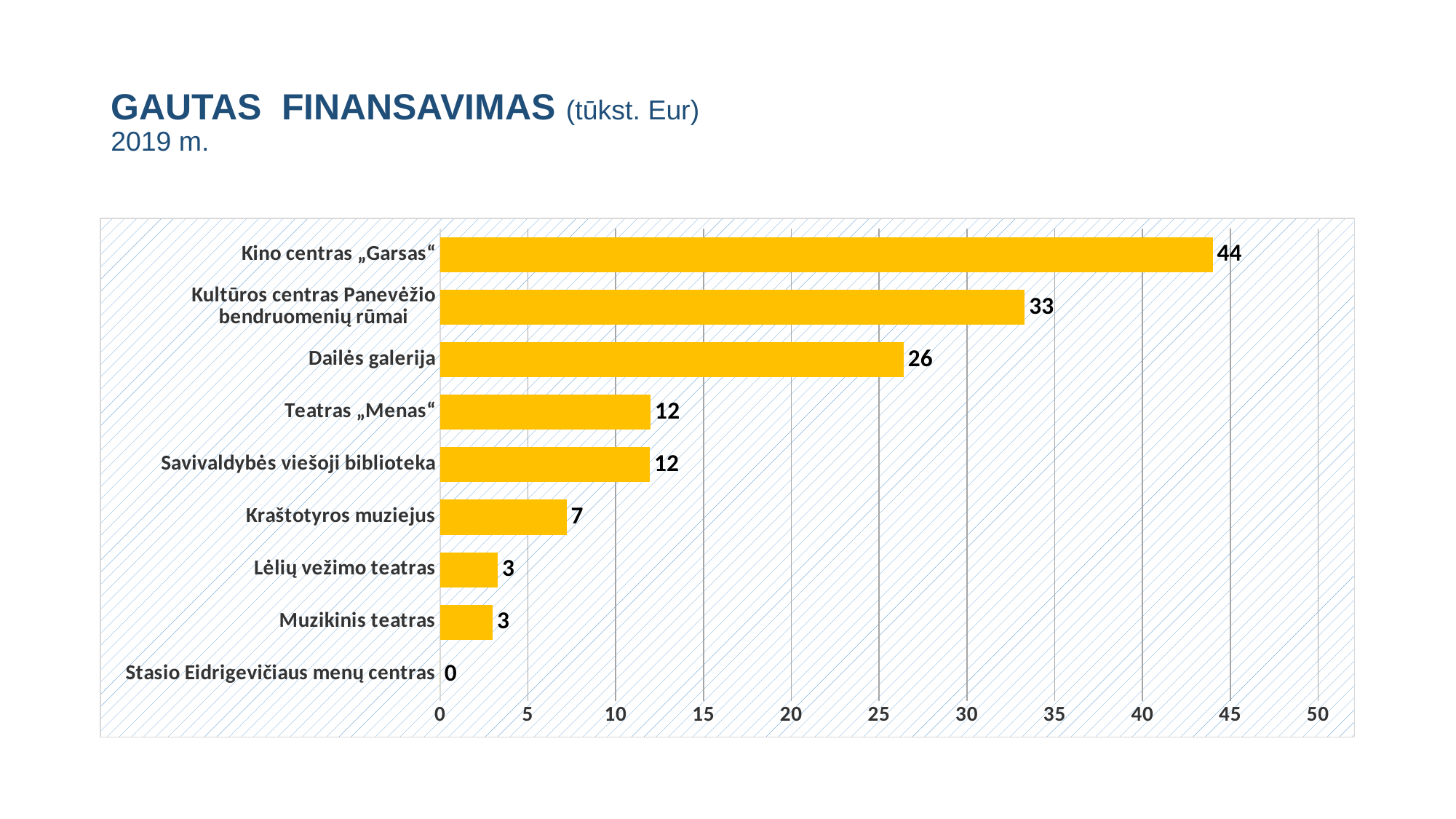
Which is larger, the value for Dailės galerija or the value for Teatras „Menas“? Dailės galerija What is the value for Dailės galerija? 26 What is the value for Kino centras „Garsas“? 44 Which category has the highest value? Kino centras „Garsas“ What unit is given in the slide title for the values? tūkst. Eur What is the value for Stasio Eidrigevičiaus menų centras? 0 What is the value for Kraštotyros muziejus? 7 What kind of chart is shown on the slide? Bar chart Which category has the lowest value? Stasio Eidrigevičiaus menų centras Is the value for Kultūros centras Panevėžio bendruomenių rūmai greater or less than 30? greater What is the difference between the values for Kino centras „Garsas“ and Kultūros centras Panevėžio bendruomenių rūmai? 11 How many categories are shown in the chart? 9